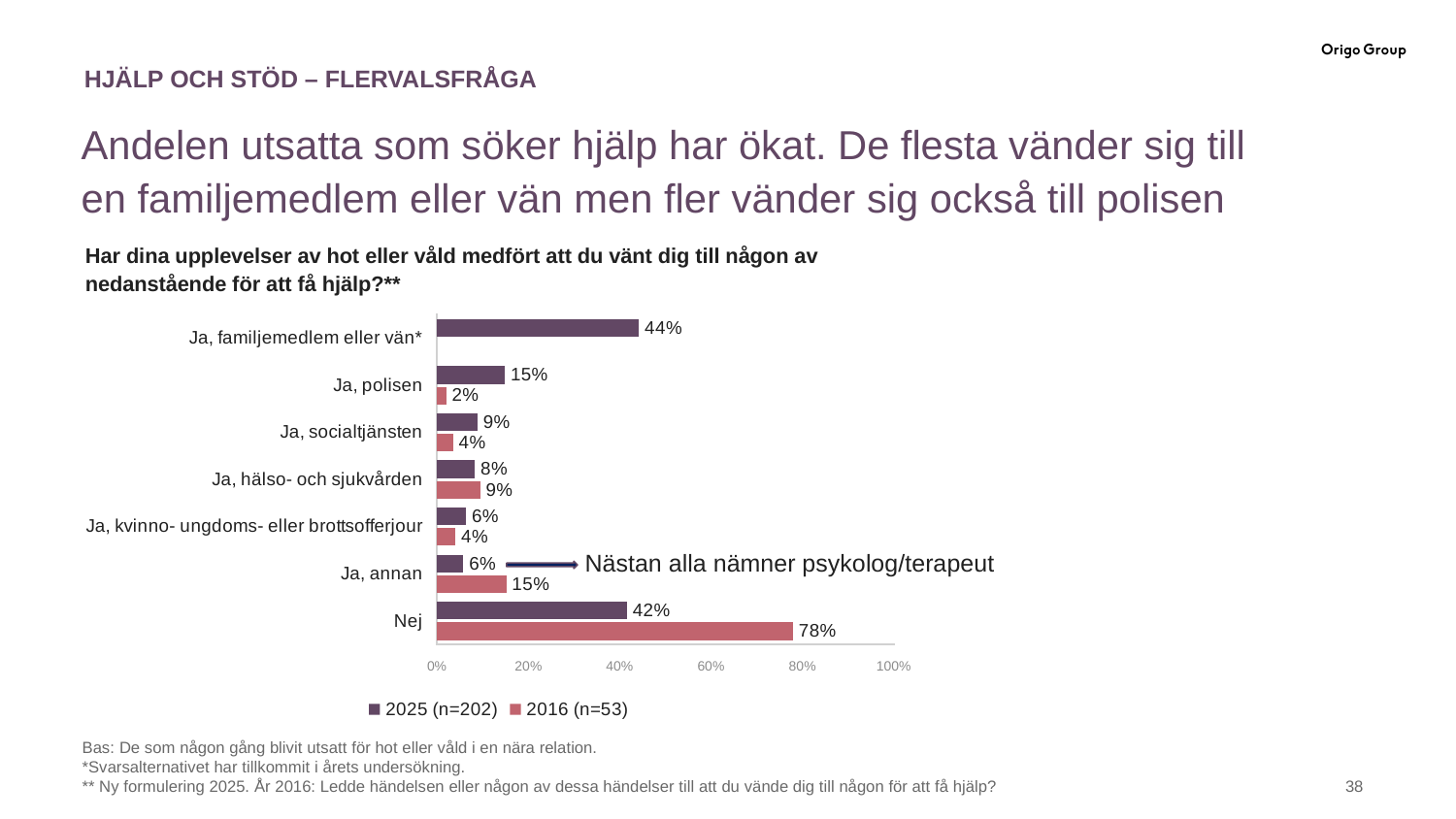
How many categories are shown on the chart? 7 What is the 2025 (n=202) value for "Ja, familjemedlem eller vän*"? 44% What annotation text is shown next to the "Ja, annan" bars? Nästan alla nämner psykolog/terapeut What is the 2025 (n=202) value for "Ja, polisen"? 15% What is the 2016 (n=53) value for "Ja, annan"? 15% Which category has the highest 2025 (n=202) value? Ja, familjemedlem eller vän* For "Ja, hälso- och sjukvården", which series has the larger value, 2025 (n=202) or 2016 (n=53)? 2016 (n=53) What is the difference between the 2016 (n=53) and 2025 (n=202) values for "Nej"? 36% What is the 2016 (n=53) value for "Nej"? 78% What kind of chart is shown on the slide? Bar chart How many series does the legend list? 2 Which category has the lowest 2016 (n=53) value? Ja, polisen